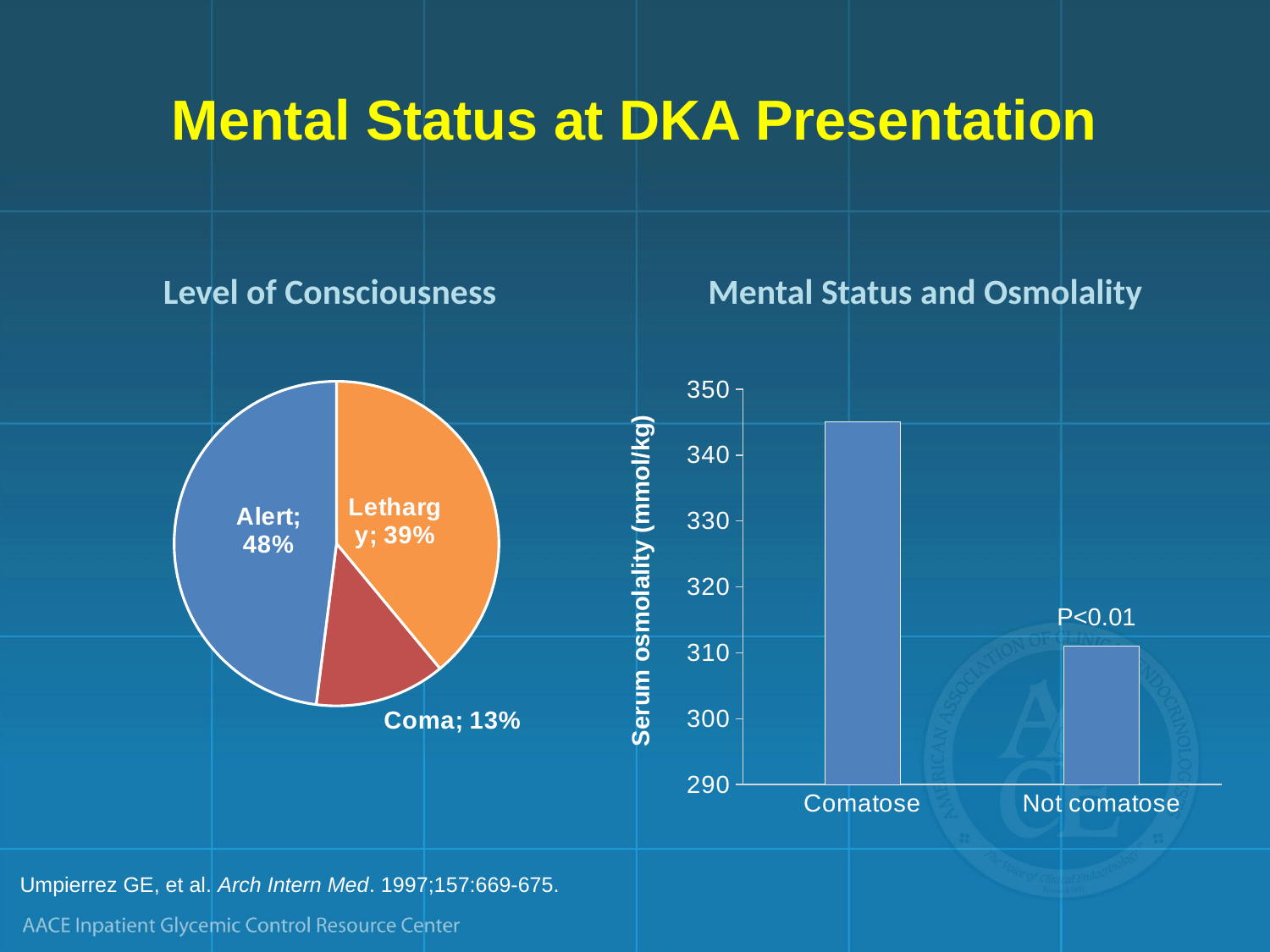
In the Level of Consciousness pie chart, what percentage of patients were Alert? 48% In the Mental Status and Osmolality chart, is the serum osmolality for Not comatose greater or less than 320? less In the Level of Consciousness pie chart, what percentage of patients were Lethargic? 39% In the Level of Consciousness pie chart, what percentage of patients were in a Coma? 13% In the Level of Consciousness pie chart, which category has the smallest share? Coma How many slices does the Level of Consciousness pie chart have? 3 In the Level of Consciousness pie chart, how many percentage points larger is the Alert share than the Lethargy share? 9 percentage points What is the y-axis label of the Mental Status and Osmolality chart? Serum osmolality (mmol/kg) What kind of chart is the Mental Status and Osmolality chart? Bar chart In the Level of Consciousness pie chart, which category has the largest share? Alert In the Mental Status and Osmolality chart, which group has the higher serum osmolality, Comatose or Not comatose? Comatose In the Mental Status and Osmolality chart, is the serum osmolality for Comatose greater or less than 340? greater